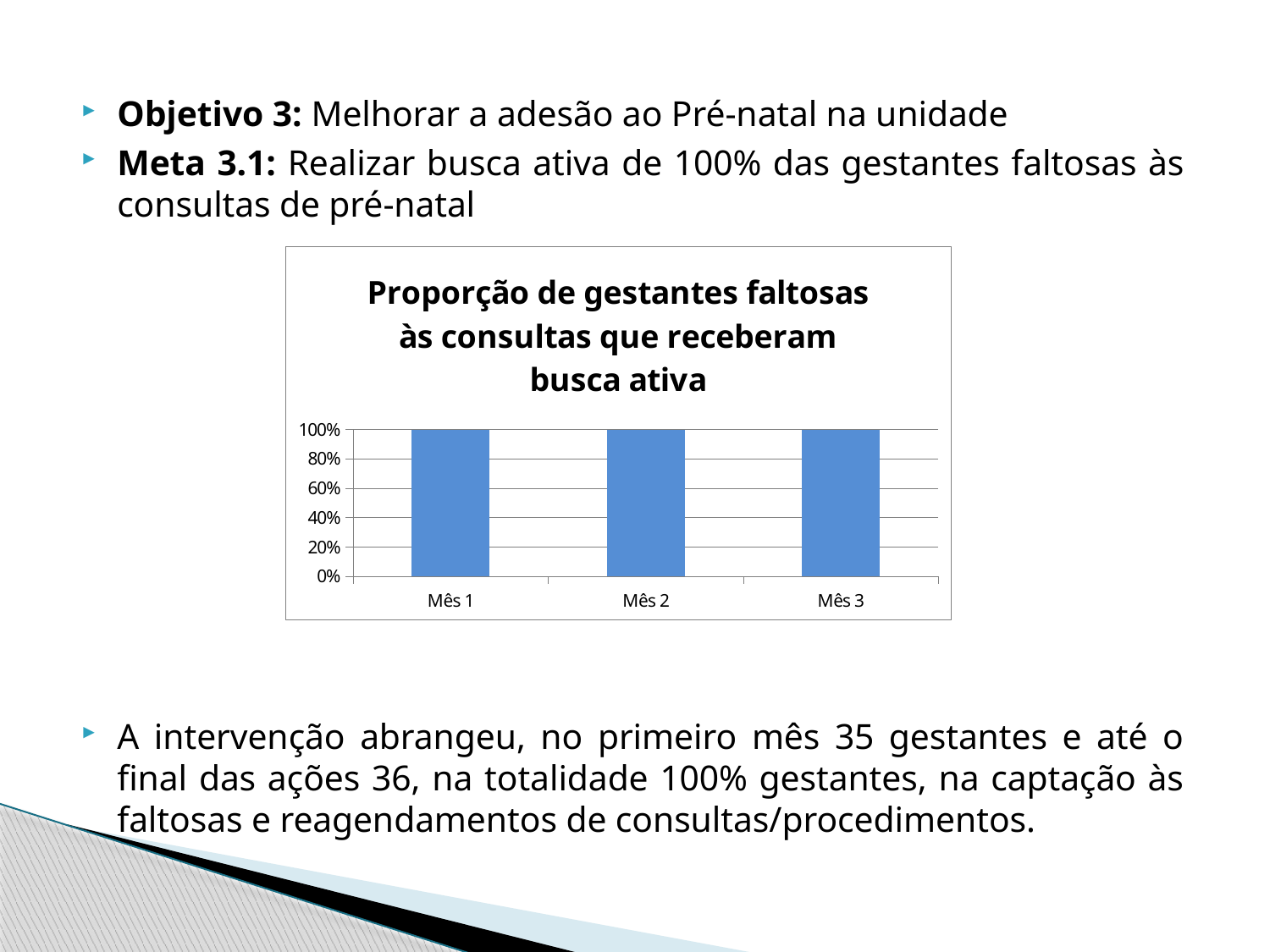
Is the value for Mês 3 greater or less than 60%? greater Is the value for Mês 2 greater or less than 80%? greater What is the value for Mês 1 in the chart? 100% What colour are the bars in the chart? blue What kind of chart is shown on the slide? bar chart What is the highest value shown on the y axis of the chart? 100% Do the values rise, fall or stay the same from Mês 1 to Mês 3? stay the same What is the value for Mês 3 in the chart? 100% What is the value for Mês 2 in the chart? 100% What is the title of the chart? Proporção de gestantes faltosas às consultas que receberam busca ativa What is the difference between the values for Mês 1 and Mês 3? 0% How many categories are shown on the x axis of the chart? 3